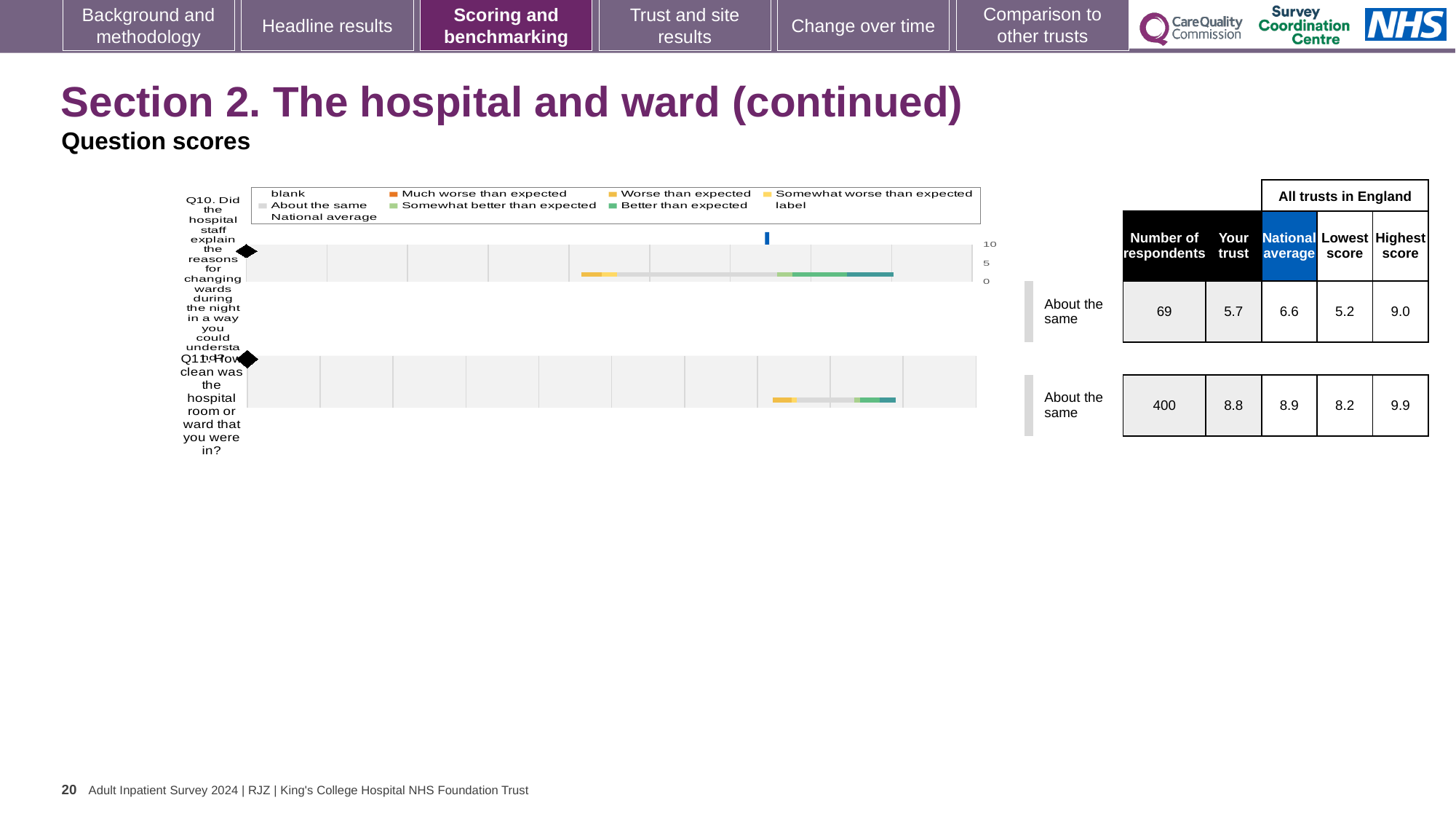
For Q10, what is the difference between the national average and the 'Your trust' score? 0.9 What is the lowest score among all trusts in England for Q10? 5.2 How many survey questions are charted on this slide? 2 Which question had more respondents, Q10 or Q11? Q11 What benchmark category is shown for Q10? About the same For Q11, which is larger: the 'Your trust' score or the national average? National average What is the highest score among all trusts in England for Q11? 9.9 For Q10 (explaining reasons for changing wards during the night), what is the 'Your trust' score? 5.7 For Q11 (how clean was the hospital room or ward), what is the national average score? 8.9 What kind of chart is used to show the question scores on this slide? Bar chart For Q11, what is the difference between the highest and lowest scores among all trusts in England? 1.7 How many respondents answered Q10? 69